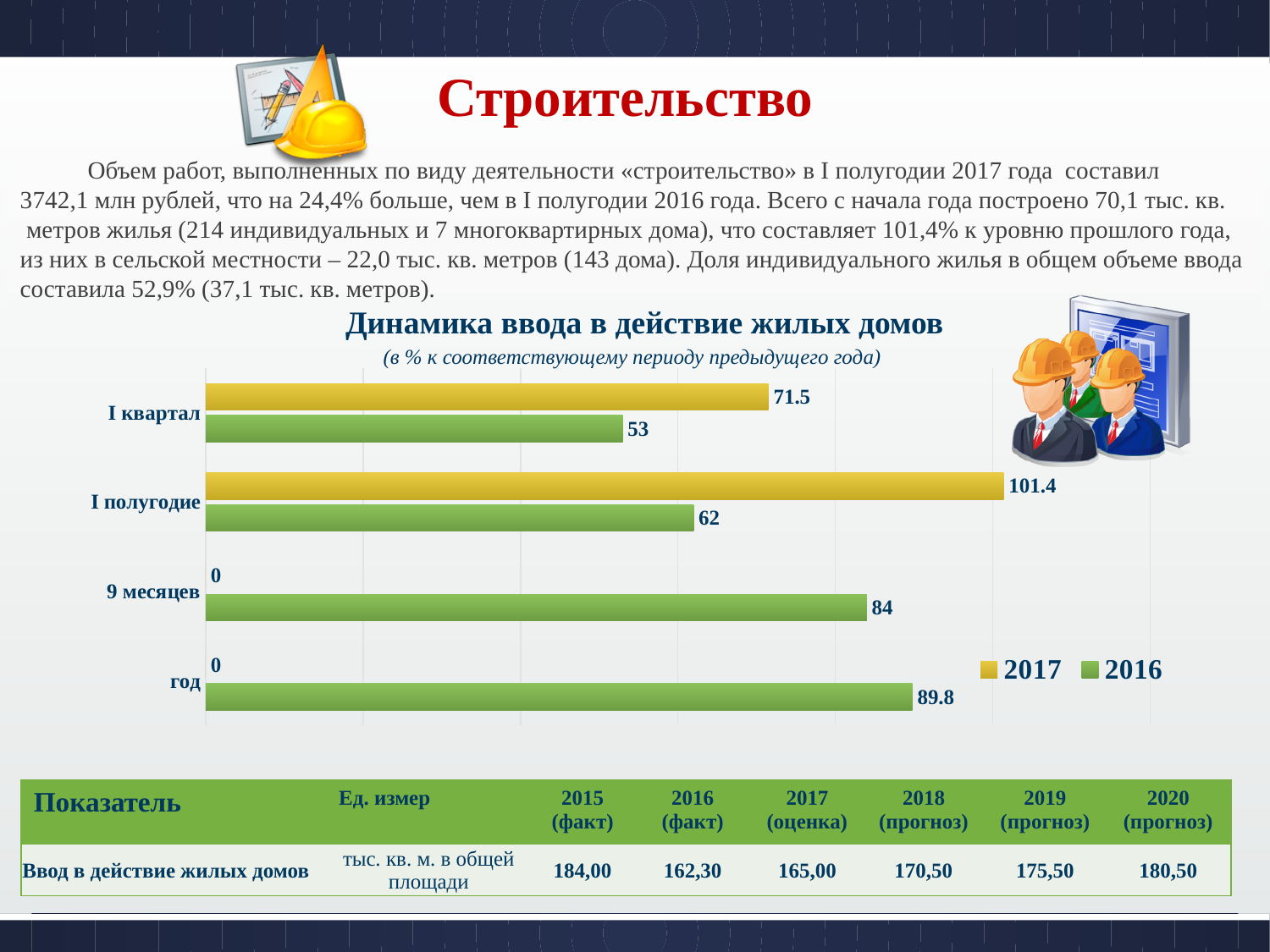
What type of chart is shown on the slide? bar chart What is the 2016 value for год? 89.8 How many series does the legend list? 2 What is the 2017 value for I полугодие? 101.4 What is the 2017 value for I квартал? 71.5 How many categories are shown on the chart? 4 For I квартал, which series has the larger value, 2017 or 2016? 2017 What is the 2016 value for 9 месяцев? 84 Which category has the lowest 2016 value? I квартал Which category has the highest 2016 value? год What is the 2016 value for I квартал? 53 What is the difference between the 2017 and 2016 values for I полугодие? 39.4